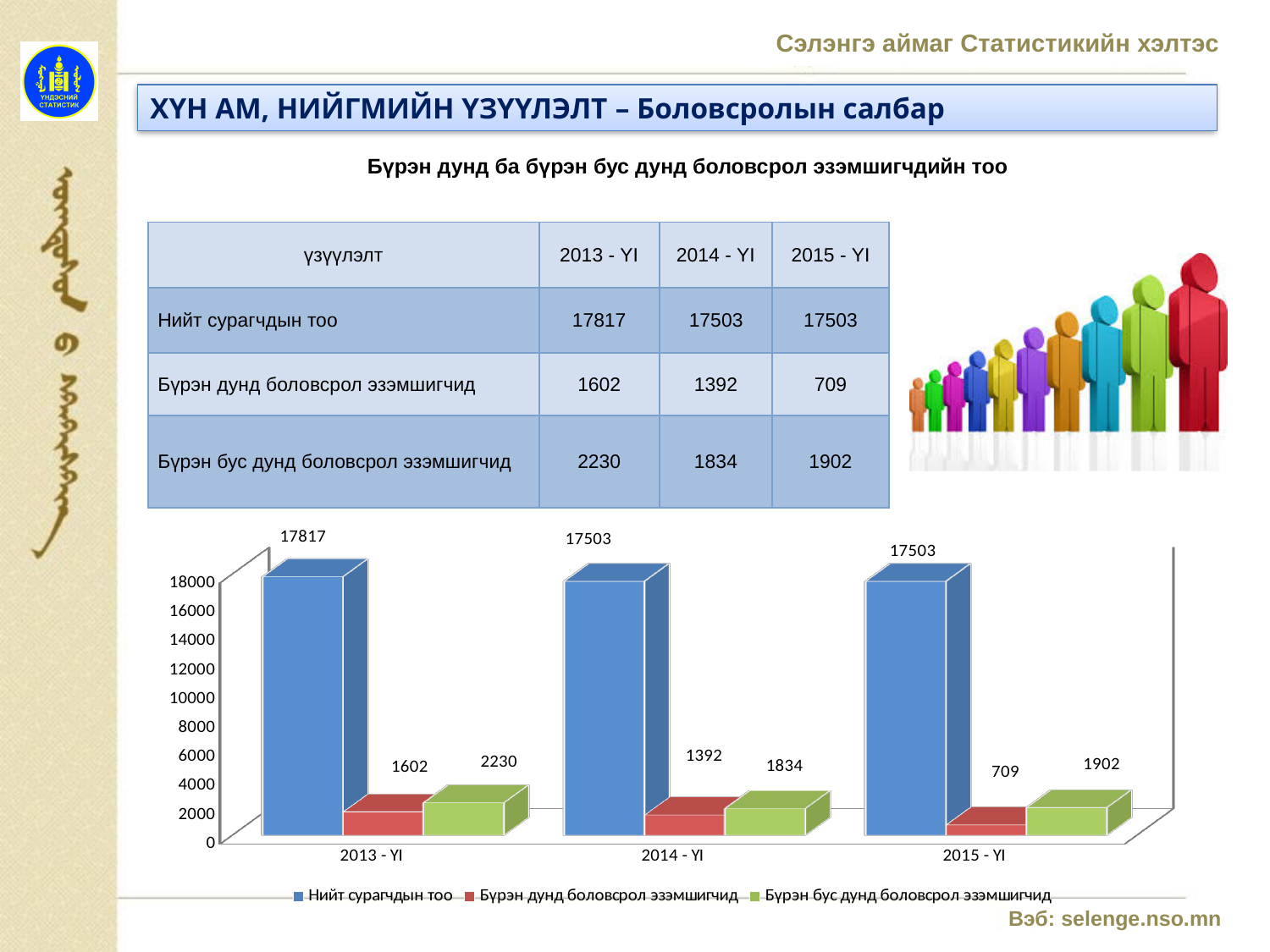
Which colour represents Нийт сурагчдын тоо in the chart? blue Does the value for Бүрэн дунд боловсрол эзэмшигчид rise or fall from 2013 - YI to 2015 - YI? fall Which is larger in 2015 - YI: Бүрэн дунд боловсрол эзэмшигчид or Бүрэн бус дунд боловсрол эзэмшигчид? Бүрэн бус дунд боловсрол эзэмшигчид What is the value for Бүрэн дунд боловсрол эзэмшигчид in 2015 - YI? 709 How many series does the chart legend list? 3 What is the value for Бүрэн бус дунд боловсрол эзэмшигчид in 2014 - YI? 1834 What kind of chart is shown on the slide? bar chart How many years are shown on the x axis of the chart? 3 What is the value for Нийт сурагчдын тоо in 2013 - YI? 17817 In which year is Бүрэн дунд боловсрол эзэмшигчид lowest? 2015 - YI In which year is Бүрэн бус дунд боловсрол эзэмшигчид highest? 2013 - YI What is the difference between Бүрэн дунд боловсрол эзэмшигчид in 2013 - YI and 2015 - YI? 893